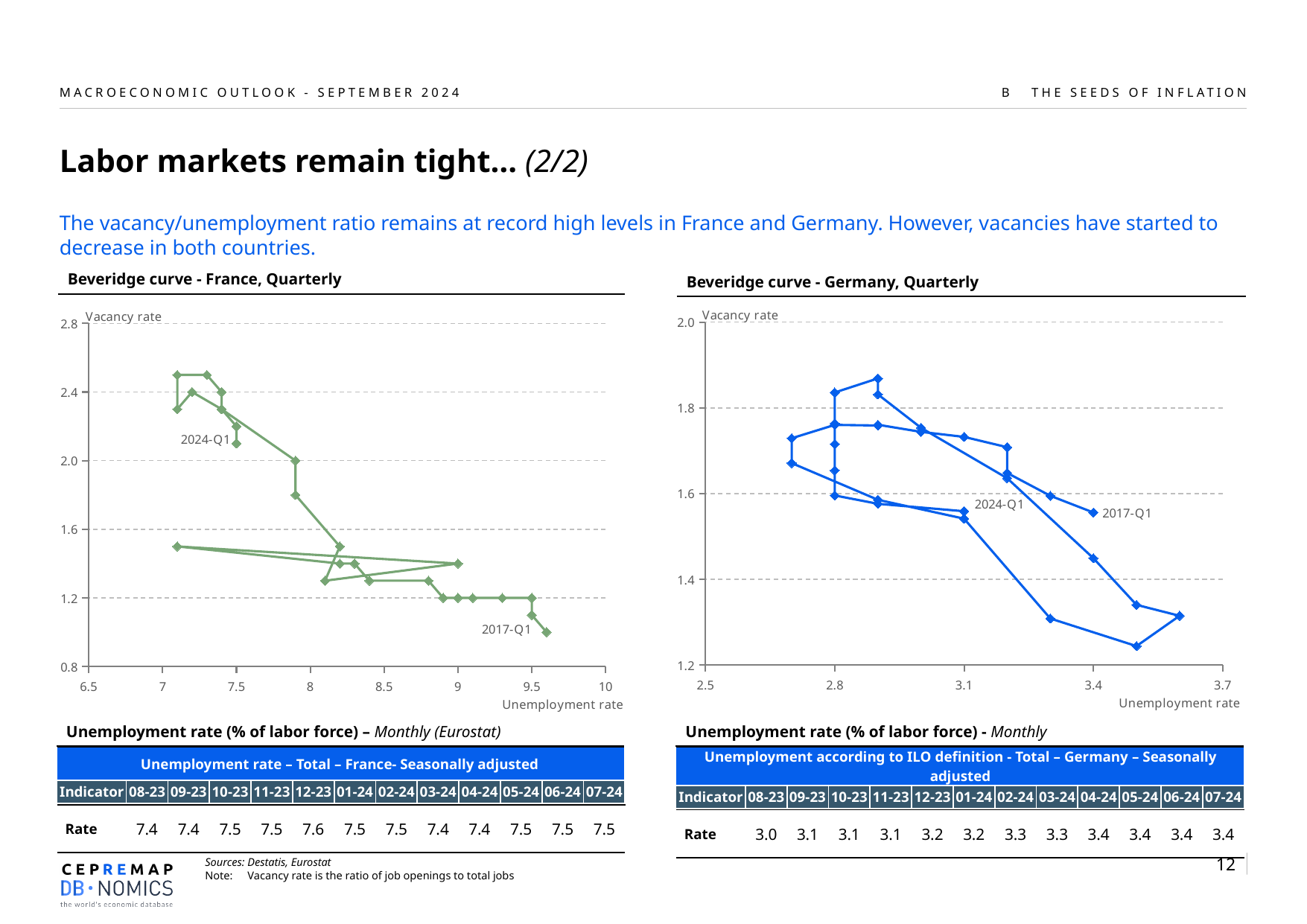
In the 'Beveridge curve - France, Quarterly' chart, does the vacancy rate generally rise or fall as the unemployment rate increases along the x axis? fall In the 'Beveridge curve - Germany, Quarterly' chart, which labelled point has the higher unemployment rate, 2024-Q1 or 2017-Q1? 2017-Q1 In the 'Beveridge curve - Germany, Quarterly' chart, what variable is plotted on the horizontal axis? Unemployment rate In the 'Beveridge curve - France, Quarterly' chart, which labelled point has the higher vacancy rate, 2024-Q1 or 2017-Q1? 2024-Q1 In the 'Beveridge curve - Germany, Quarterly' chart, is the vacancy rate for 2017-Q1 greater or less than 1.4? greater In the 'Beveridge curve - France, Quarterly' chart, what variable is plotted on the vertical axis? Vacancy rate In the 'Beveridge curve - France, Quarterly' chart, is the unemployment rate for 2017-Q1 greater or less than 9? greater In the 'Beveridge curve - Germany, Quarterly' chart, is the unemployment rate for 2017-Q1 greater or less than 3.1? greater What kind of chart is the 'Beveridge curve - France, Quarterly' chart? scatter chart with connected points